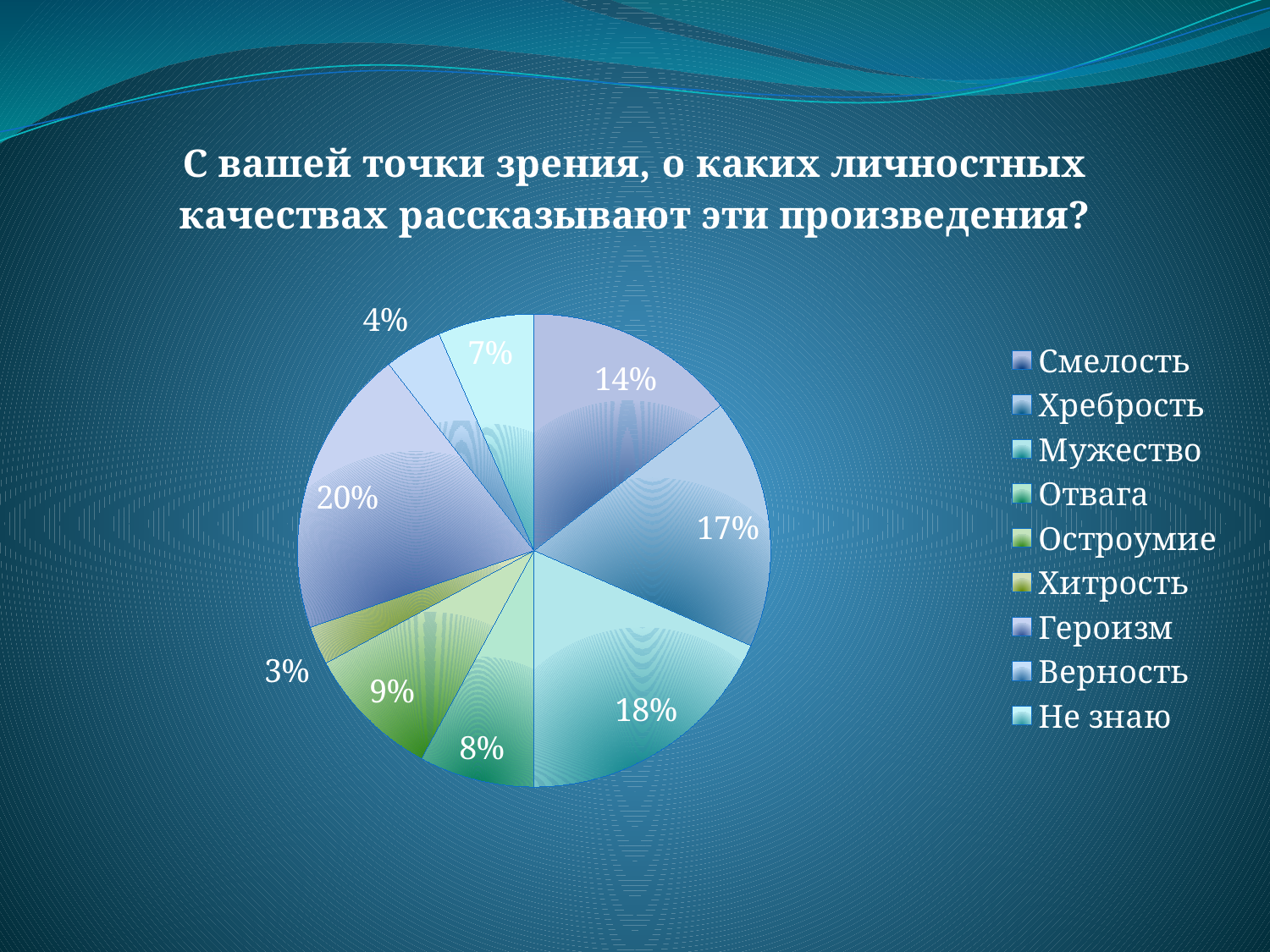
What percentage is shown for Не знаю? 7% What percentage is shown for Хитрость? 3% What percentage is shown for Мужество? 18% Which category has the smallest share of the pie? Хитрость How many categories does the pie chart have? 9 What is the combined share of Отвага and Остроумие? 17% What percentage is shown for Героизм? 20% What is the difference between the shares for Героизм and Смелость? 6% What type of chart is shown on the slide? pie chart Which category has the largest share of the pie? Героизм Which is larger, the share for Хребрость or the share for Смелость? Хребрость What is the title of the chart? С вашей точки зрения, о каких личностных качествах рассказывают эти произведения?